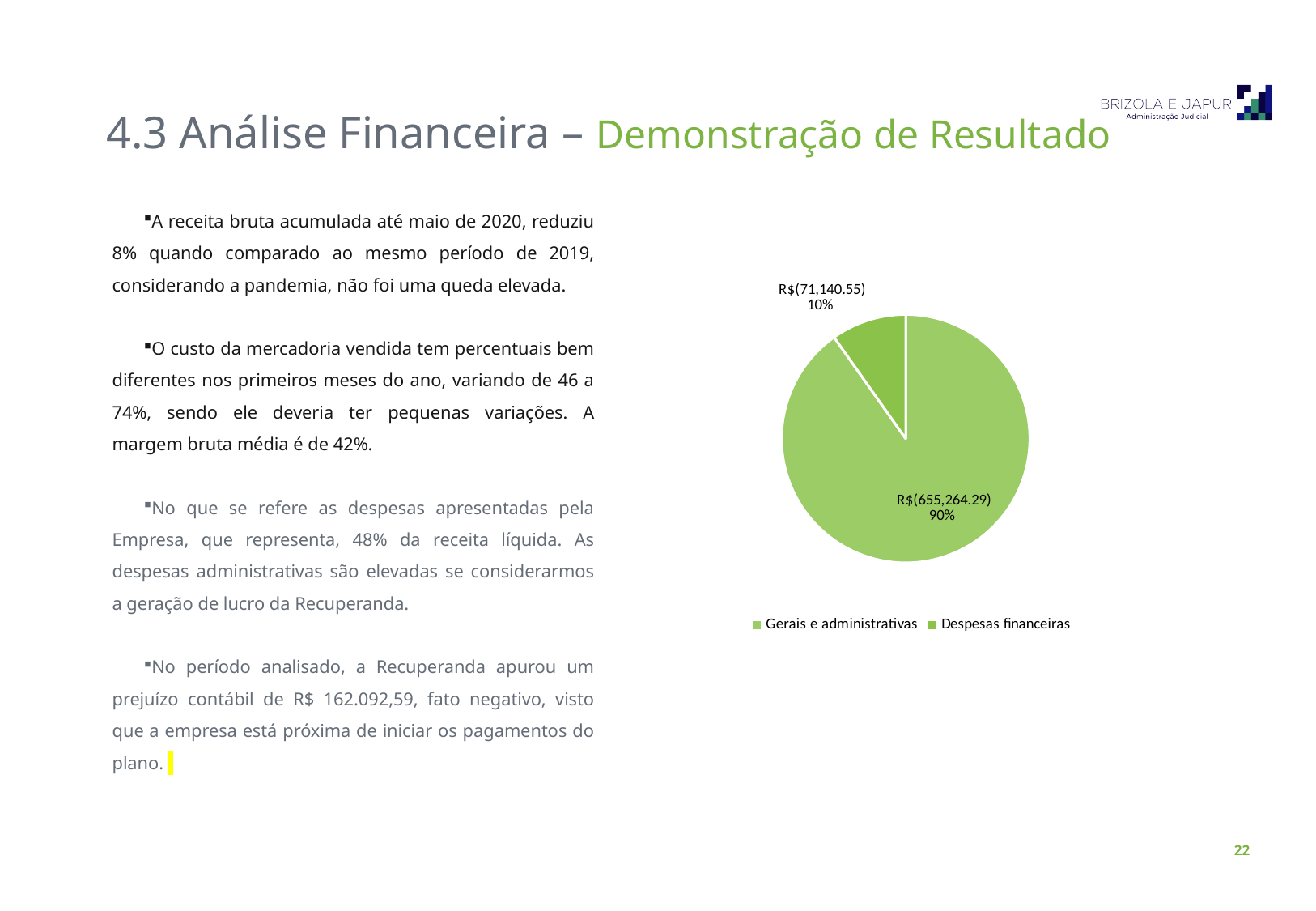
What value is shown for Despesas financeiras in the pie chart? R$(71,140.55) What kind of chart is shown on the slide? pie chart How many entries does the legend of the pie chart list? 2 What share of the pie does Gerais e administrativas represent? 90% Which slice of the pie chart is the largest? Gerais e administrativas What value is shown for Gerais e administrativas in the pie chart? R$(655,264.29) What are the two legend entries of the pie chart? Gerais e administrativas; Despesas financeiras Which is larger in the pie chart, Gerais e administrativas or Despesas financeiras? Gerais e administrativas What is the difference in percentage points between the Gerais e administrativas share and the Despesas financeiras share? 80 percentage points What share of the pie does Despesas financeiras represent? 10% How many slices does the pie chart have? 2 Which slice of the pie chart is the smallest? Despesas financeiras